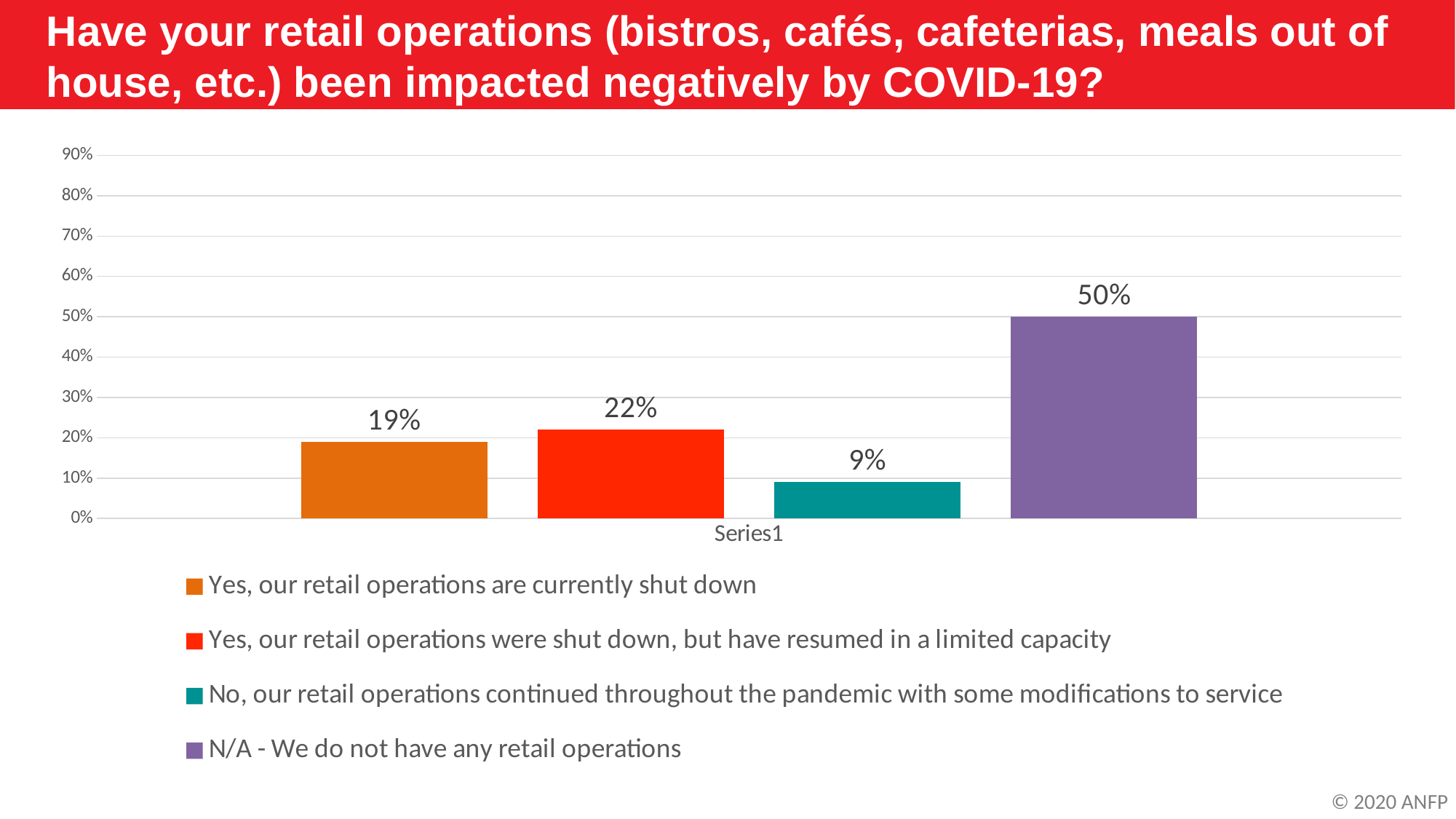
What percentage of respondents said their retail operations were shut down but have resumed in a limited capacity? 22% What is the difference in percentage points between the N/A response and the 'currently shut down' response? 31 What type of chart is shown on the slide? Bar chart What percentage of respondents said their retail operations continued throughout the pandemic with some modifications to service? 9% How many response categories are shown in the chart? 4 What colour is the bar for 'N/A - We do not have any retail operations'? Purple What percentage of respondents said they do not have any retail operations (N/A)? 50% Which is larger: the share for 'currently shut down' or the share for 'shut down, but have resumed in a limited capacity'? Yes, our retail operations were shut down, but have resumed in a limited capacity What is the combined percentage of the two 'Yes' responses? 41% What percentage of respondents said their retail operations are currently shut down? 19% Which response has the lowest percentage? No, our retail operations continued throughout the pandemic with some modifications to service Which response has the highest percentage? N/A - We do not have any retail operations